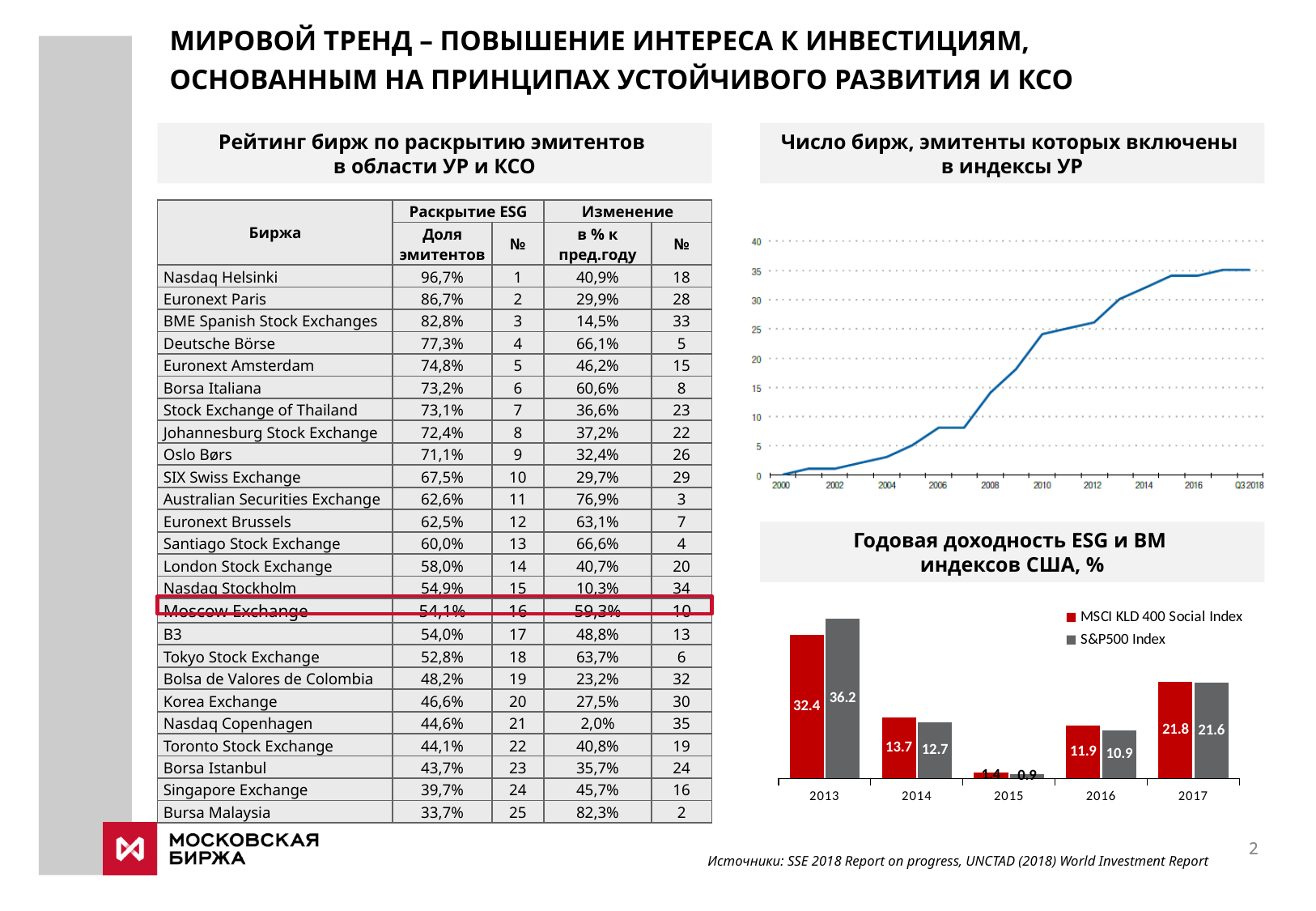
What kind of chart is the chart titled "Число бирж, эмитенты которых включены в индексы УР"? line chart What kind of chart is the chart titled "Годовая доходность ESG и BM индексов США, %"? bar chart How many years are shown on the x axis of the chart "Годовая доходность ESG и BM индексов США, %"? 5 In the chart "Годовая доходность ESG и BM индексов США, %", what is the value for the MSCI KLD 400 Social Index in 2013? 32.4 In the chart "Годовая доходность ESG и BM индексов США, %", which year has the highest value for the S&P500 Index? 2013 In the chart "Годовая доходность ESG и BM индексов США, %", which series has the larger value in 2016, MSCI KLD 400 Social Index or S&P500 Index? MSCI KLD 400 Social Index In the chart "Годовая доходность ESG и BM индексов США, %", which year has the lowest value for the MSCI KLD 400 Social Index? 2015 In the chart "Число бирж, эмитенты которых включены в индексы УР", do the values generally rise or fall from 2000 to Q3 2018? rise In the chart "Число бирж, эмитенты которых включены в индексы УР", is the value for 2010 greater or less than 20? greater In the chart "Годовая доходность ESG и BM индексов США, %", what is the value for the S&P500 Index in 2017? 21.6 How many series does the legend of the chart "Годовая доходность ESG и BM индексов США, %" list? 2 In the chart "Годовая доходность ESG и BM индексов США, %", what is the difference between the S&P500 Index and the MSCI KLD 400 Social Index in 2013? 3.8